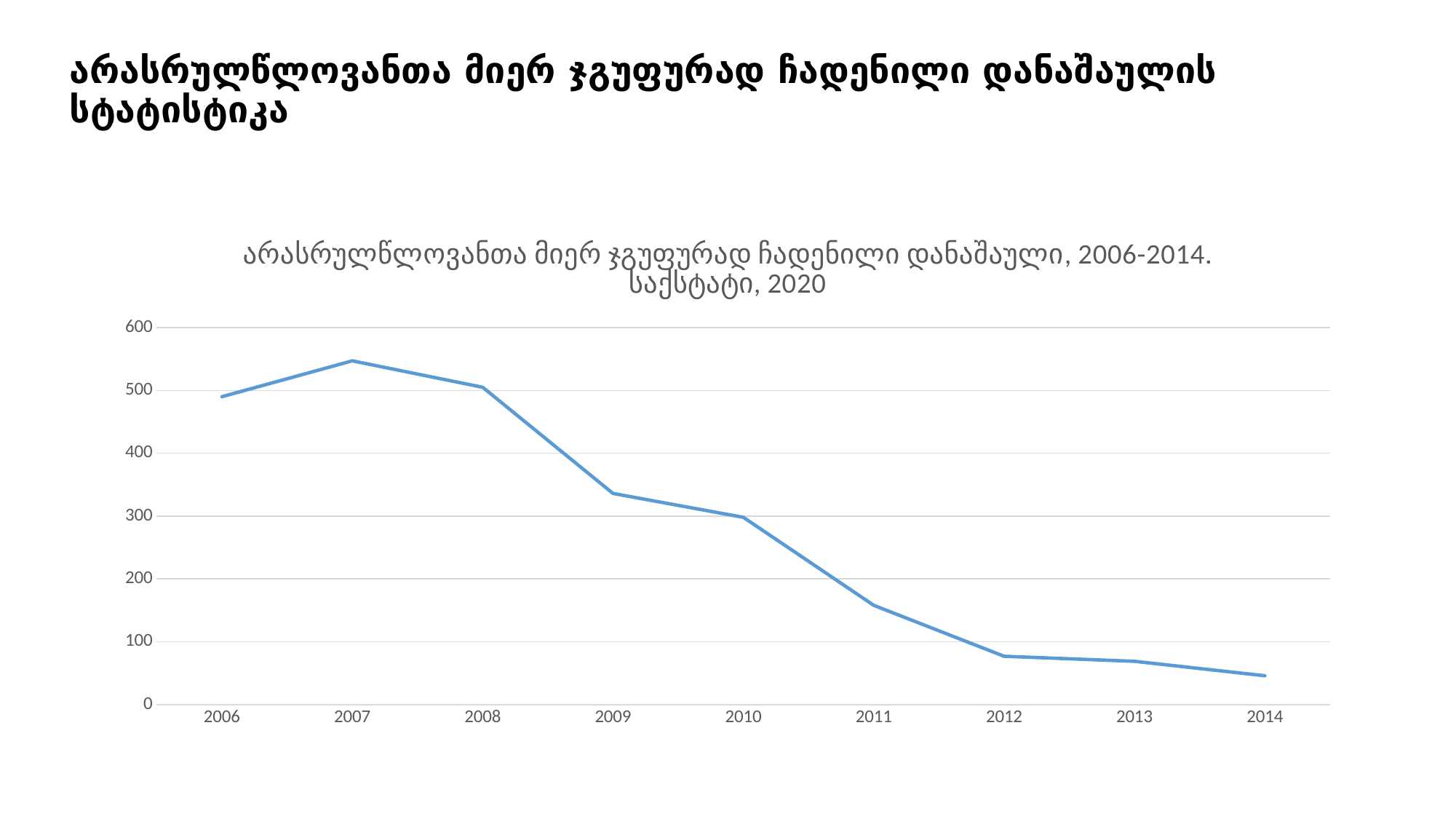
Is the value for 2009 greater or less than 400? less Which year has the larger value, 2007 or 2011? 2007 What kind of chart is shown on the slide? line chart Is the value for 2006 greater or less than 400? greater Which year has the highest value on the chart? 2007 Is the value for 2007 greater or less than 500? greater Which year has the lowest value on the chart? 2014 What is the first year shown on the x axis of the chart? 2006 How many years are plotted along the x axis of the chart? 9 Do the values generally rise or fall from 2007 to 2014? fall